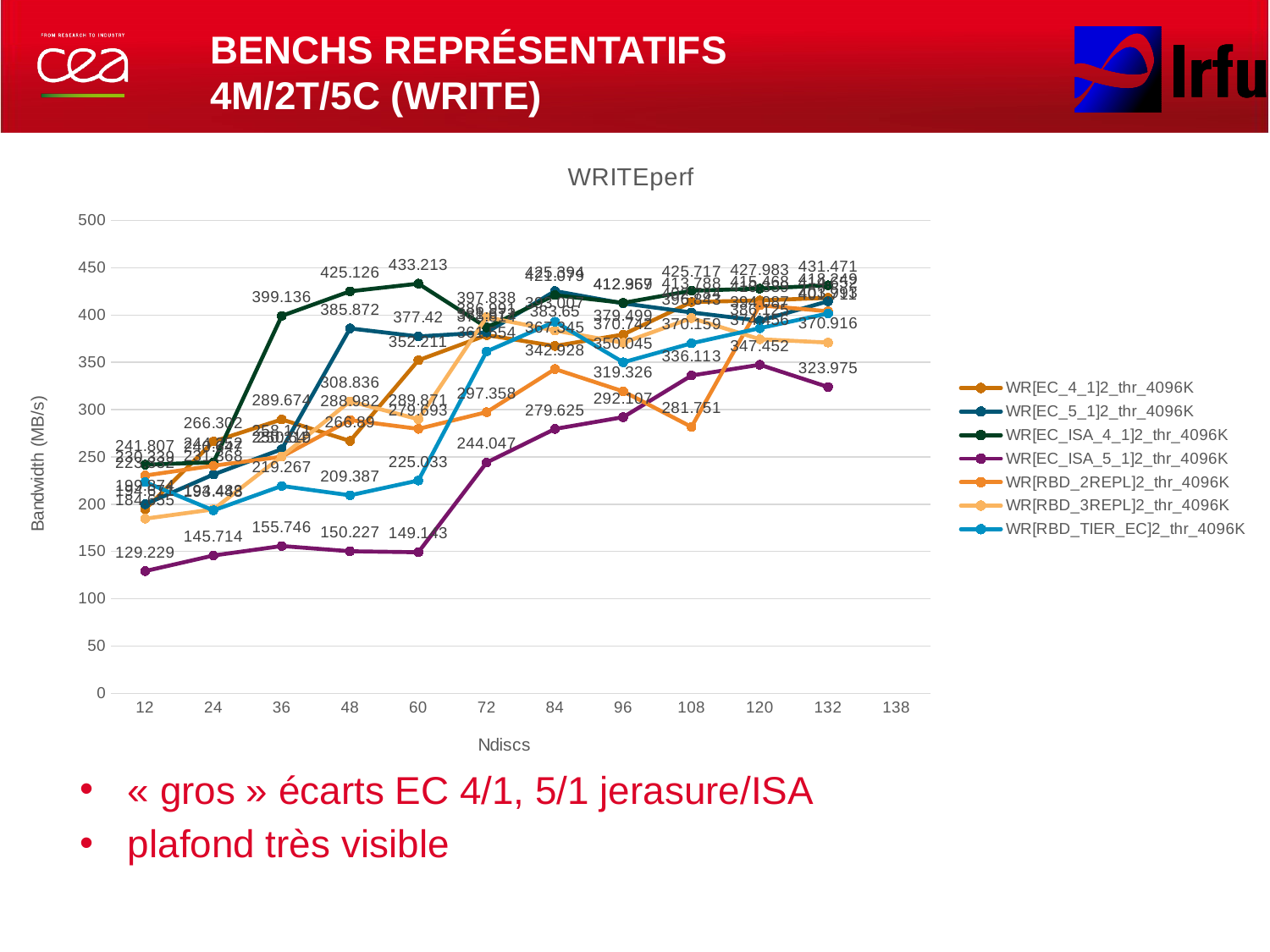
Which series has the highest value at 60 discs? WR[EC_ISA_4_1]2_thr_4096K What is the value of WR[EC_ISA_5_1]2_thr_4096K at 24 discs? 145.714 What is the value of WR[EC_ISA_5_1]2_thr_4096K at 12 discs? 129.229 Which series has the lowest value at 12 discs? WR[EC_ISA_5_1]2_thr_4096K How many series does the legend of the WRITEperf chart list? 7 What is the title of the chart? WRITEperf What kind of chart is shown on the slide? line chart By how much does WR[EC_ISA_5_1]2_thr_4096K increase from 60 discs (149.143) to 72 discs (244.047)? 94.904 Is the value of WR[EC_ISA_5_1]2_thr_4096K at 132 discs greater or less than 350? less What is the label of the vertical axis? Bandwidth (MB/s) What is the value of WR[EC_ISA_4_1]2_thr_4096K at 60 discs? 433.213 What is the value of WR[EC_ISA_5_1]2_thr_4096K at 72 discs? 244.047